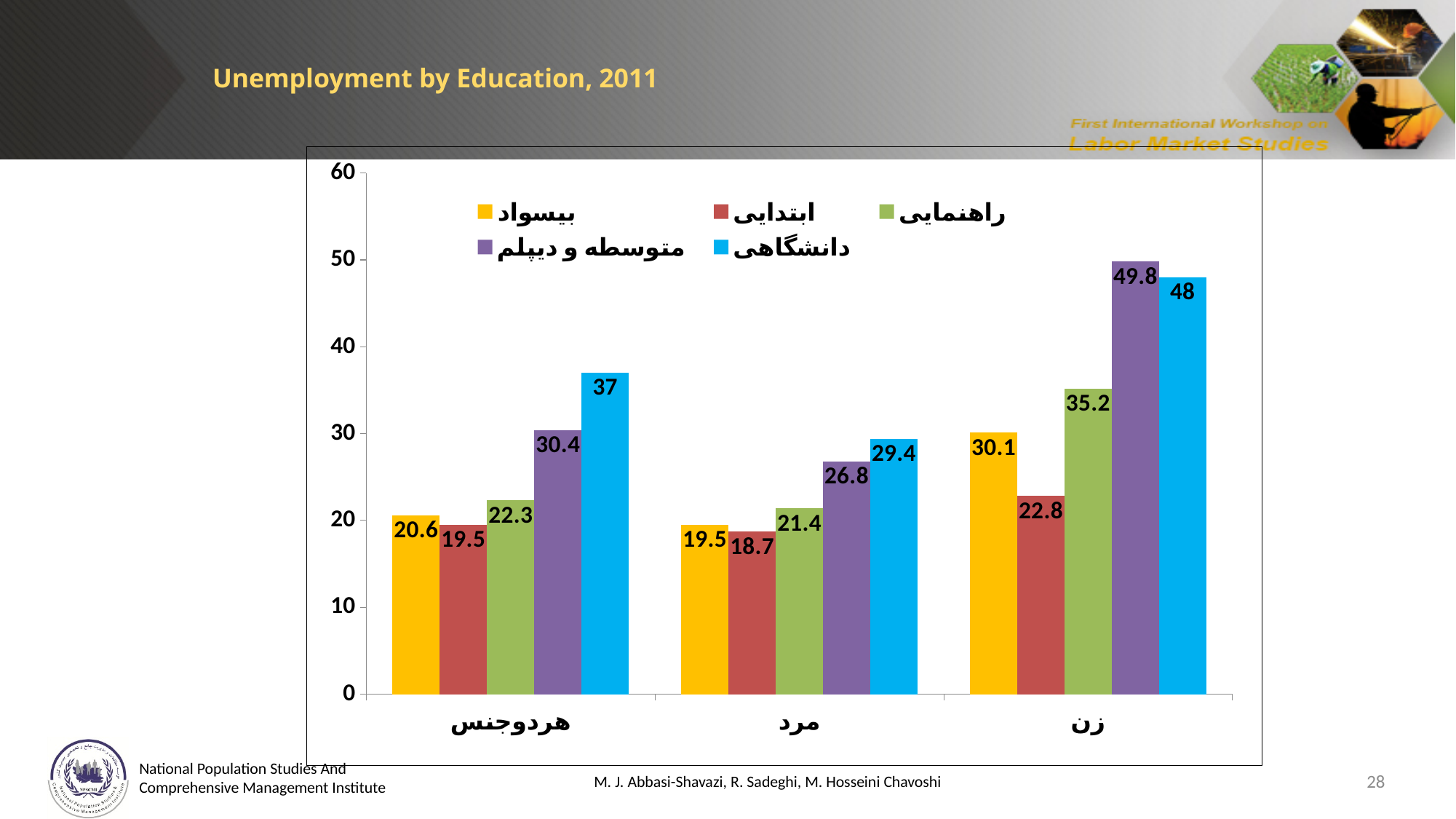
What is the title of the slide? Unemployment by Education, 2011 What is the value for بیسواد in the مرد category? 19.5 What kind of chart is shown on the slide? bar chart What is the difference between the دانشگاهی values for زن and مرد? 18.6 Which series has the highest value in the زن category? متوسطه و دیپلم Which is larger: راهنمایی for زن or دانشگاهی for هردوجنس? دانشگاهی for هردوجنس What colour are the bars for the دانشگاهی series? blue How many series does the legend list? 5 Which series has the lowest value in the مرد category? ابتدایی What is the value for دانشگاهی in the زن category? 48 What is the value for متوسطه و دیپلم in the هردوجنس category? 30.4 How many categories are shown on the x axis? 3